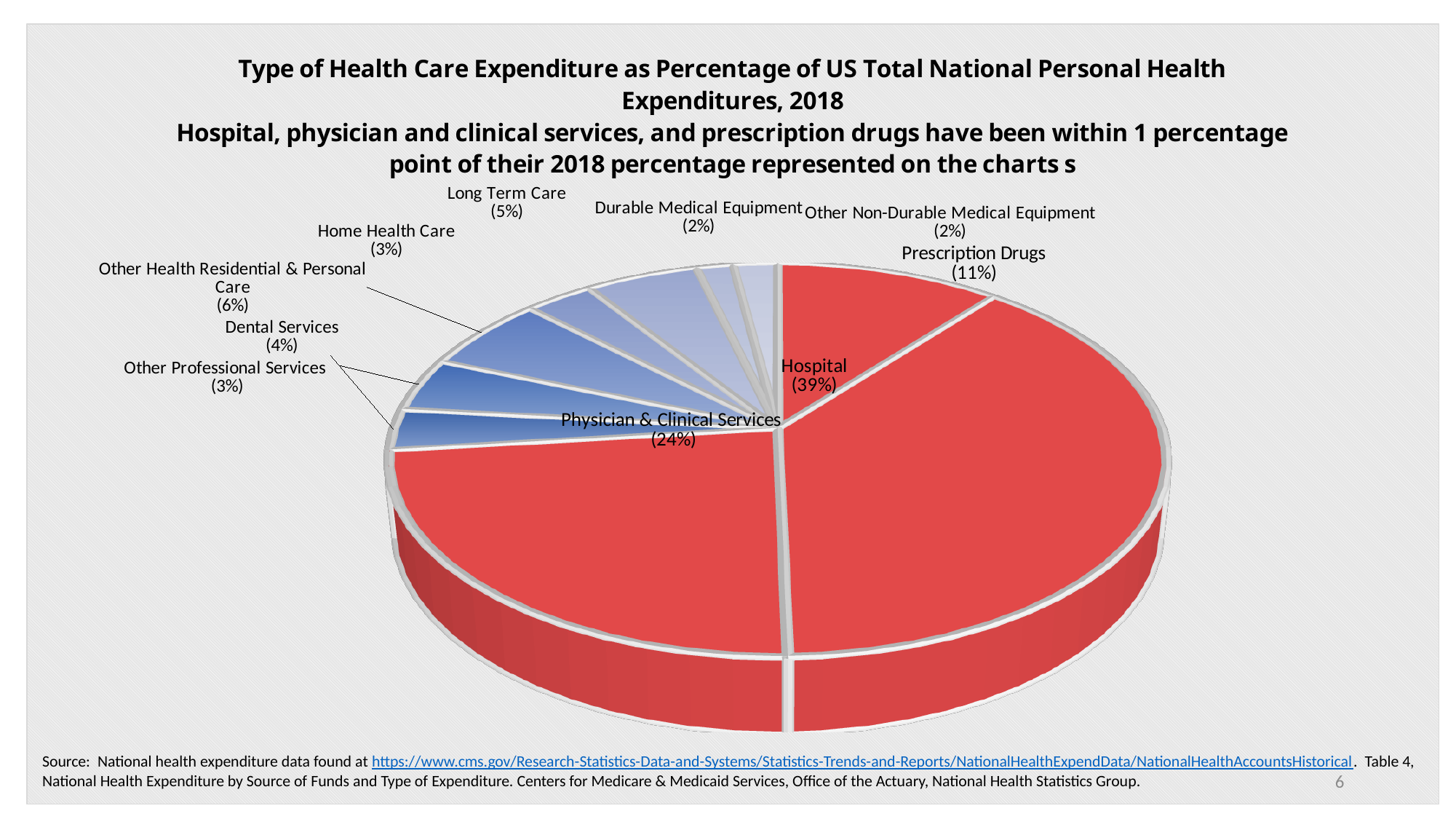
How many categories (slices) does the pie chart show? 10 What percentage is shown for Long Term Care? 5% What is the combined percentage of Durable Medical Equipment and Other Non-Durable Medical Equipment? 4% What year does the chart title say the data is for? 2018 What is the difference in percentage points between Hospital and Physician & Clinical Services? 15 Which type of health care expenditure has the largest share of the pie? Hospital What percentage is shown for Prescription Drugs? 11% What kind of chart is shown on the slide? pie chart What percentage of US total national personal health expenditures in 2018 was for Hospital? 39% Which is larger, the share for Dental Services or the share for Home Health Care? Dental Services What percentage is shown for Physician & Clinical Services? 24% What percentage is shown for Other Health Residential & Personal Care? 6%